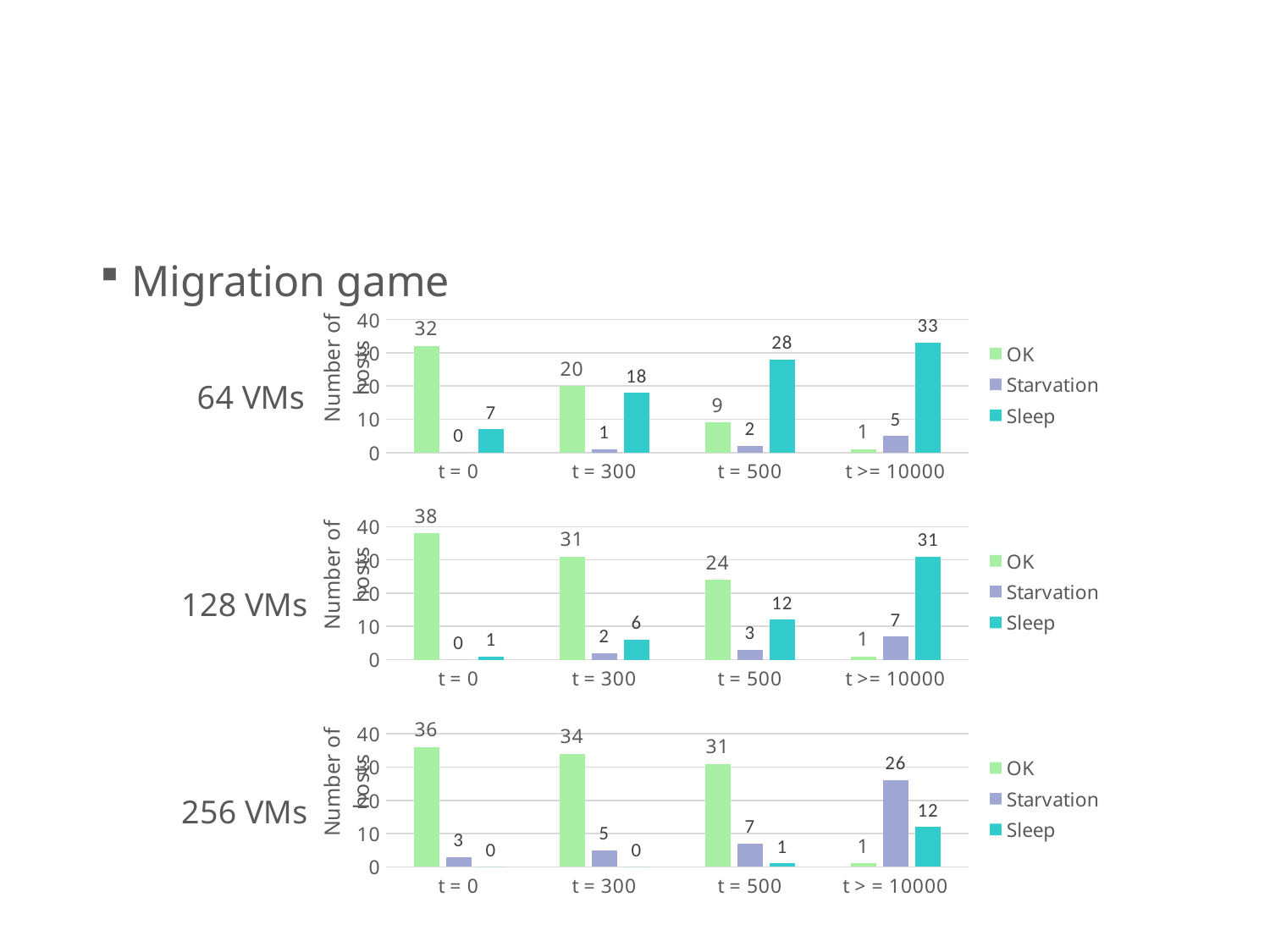
In the 128 VMs chart, what is the value of OK at t = 0? 38 In the 256 VMs chart, what is the value of Starvation at t > = 10000? 26 In the 256 VMs chart, what is the difference between the OK values at t = 0 and t = 500? 5 In the 128 VMs chart, at which category is the Sleep value lowest? t = 0 In the 64 VMs chart, which is larger at t = 300: OK or Sleep? OK In the 64 VMs chart, does the OK value rise or fall from t = 0 to t >= 10000? Fall In the 64 VMs chart, what is the value of Sleep at t = 500? 28 How many series does the legend of the 64 VMs chart list? 3 In the 64 VMs chart, at which category is the OK value highest? t = 0 What kind of chart is the 128 VMs chart? Bar chart How many categories are shown on the x axis of the 256 VMs chart? 4 In the 128 VMs chart, is the Sleep value at t >= 10000 greater or less than 20? greater